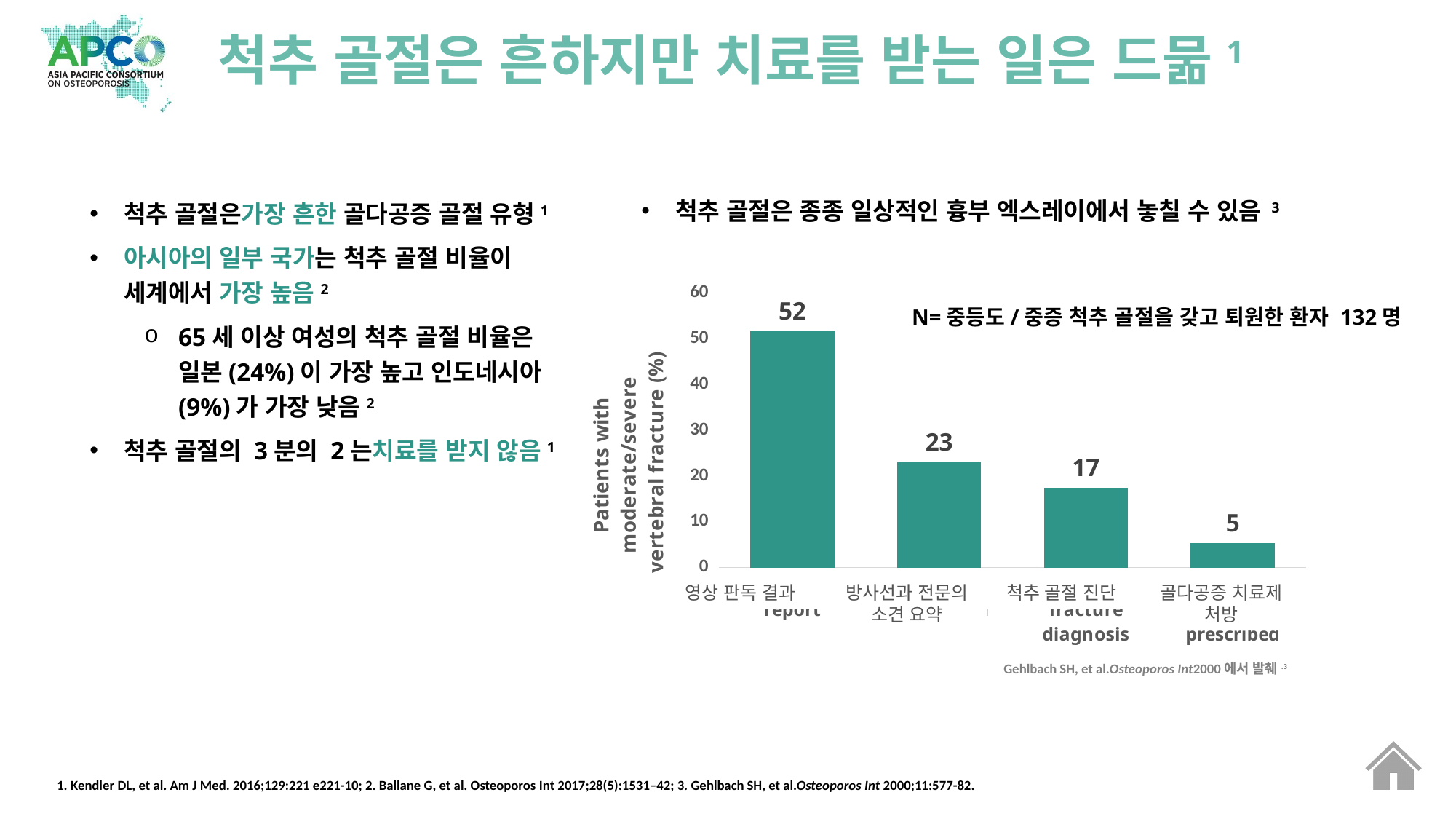
What is the value for 골다공증 치료제 처방? 5 How many categories are plotted in the bar chart? 4 What type of chart is shown on the slide? bar chart Which is larger, the value for 방사선과 전문의 소견 요약 or the value for 척추 골절 진단? 방사선과 전문의 소견 요약 Which category has the highest value? 영상 판독 결과 What is the difference between the values for 영상 판독 결과 and 골다공증 치료제 처방? 47 Which category has the lowest value? 골다공증 치료제 처방 What is the value for 척추 골절 진단? 17 Do the values rise or fall from left to right along the x axis? fall What is the label of the vertical axis of the chart? Patients with moderate/severe vertebral fracture (%) What is the value for 영상 판독 결과? 52 What is the value for 방사선과 전문의 소견 요약? 23